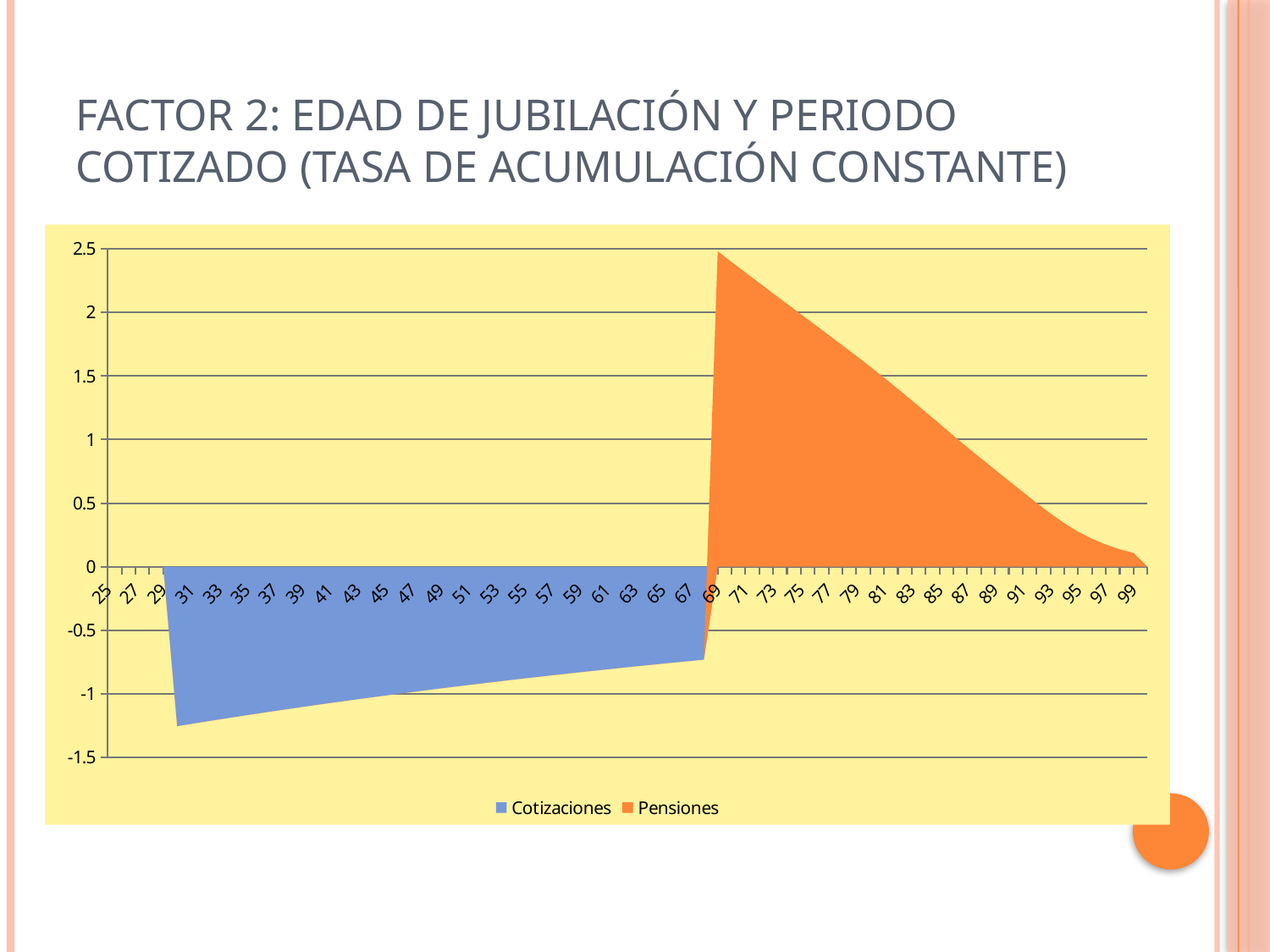
What kind of chart is shown on the slide? area chart What are the two series named in the legend? Cotizaciones and Pensiones How many series does the legend list? 2 Which colour represents the Pensiones series? orange Do the Pensiones values rise or fall as age increases from 69 to 99? fall What is the highest value shown on the vertical axis? 2.5 Is the value for Cotizaciones at age 31 greater or less than -1? less Is the value for Cotizaciones at age 67 greater or less than -1? greater Is the value for Pensiones at age 91 greater or less than 1? less Which series has positive values, Cotizaciones or Pensiones? Pensiones Which of the two series reaches a higher absolute peak, Cotizaciones or Pensiones? Pensiones